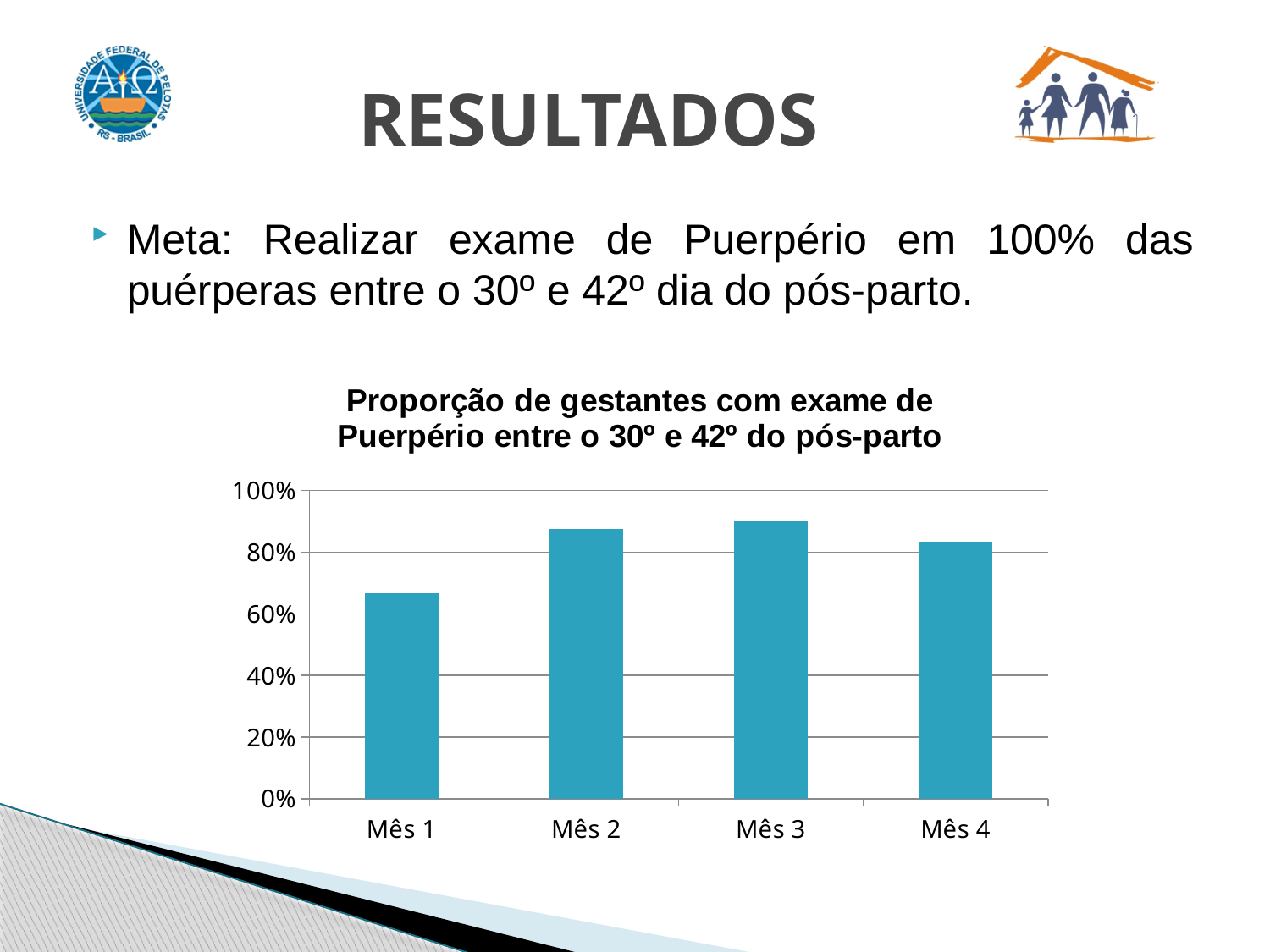
How many months (categories) are shown on the x axis of the chart? 4 What kind of chart is shown on the slide? bar chart Which is larger, the value for Mês 2 or the value for Mês 1? Mês 2 Is the value for Mês 2 greater or less than 80%? greater Is the value for Mês 1 greater or less than 60%? greater What is the title of the chart? Proporção de gestantes com exame de Puerpério entre o 30º e 42º do pós-parto Does the value rise or fall from Mês 1 to Mês 2? rise Is the value for Mês 1 greater or less than 80%? less Which month has the highest proportion in the chart? Mês 3 Which is larger, the value for Mês 3 or the value for Mês 4? Mês 3 Which month has the lowest proportion in the chart? Mês 1